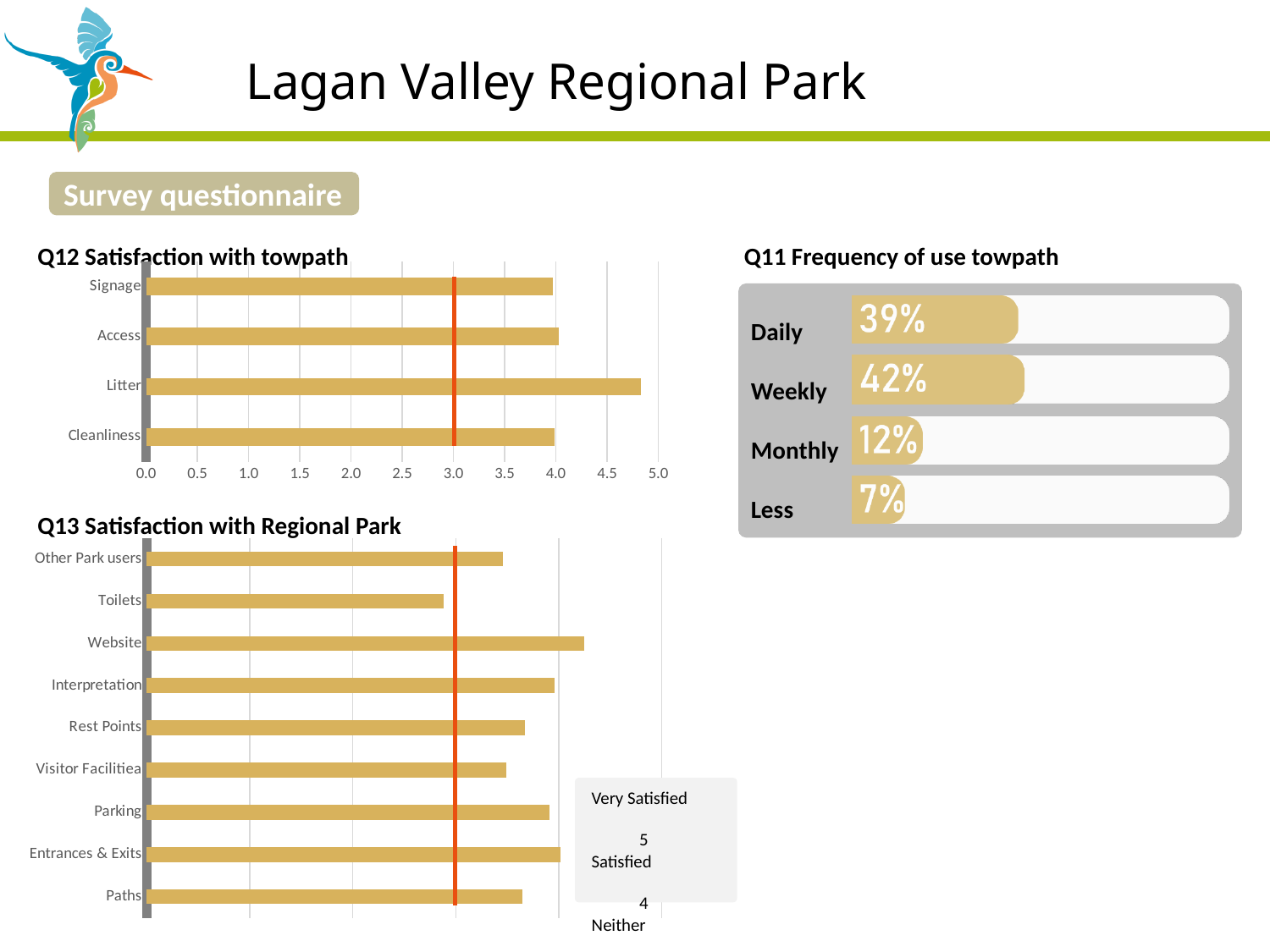
How many categories are shown in the 'Q12 Satisfaction with towpath' chart? 4 In the 'Q12 Satisfaction with towpath' chart, is the value for Cleanliness greater or less than 3.0? greater In the 'Q11 Frequency of use towpath' chart, what is the value for Weekly? 42% How many categories are shown in the 'Q13 Satisfaction with Regional Park' chart? 9 In the 'Q13 Satisfaction with Regional Park' chart, which is larger, the value for Interpretation or the value for Rest Points? Interpretation In the 'Q13 Satisfaction with Regional Park' chart, which category has the highest value? Website In the 'Q12 Satisfaction with towpath' chart, is the value for Litter greater or less than 4.5? greater In the 'Q13 Satisfaction with Regional Park' chart, which category has the lowest value? Toilets In the 'Q11 Frequency of use towpath' chart, which category has the lowest value? Less In the 'Q12 Satisfaction with towpath' chart, which category has the highest value? Litter In the 'Q11 Frequency of use towpath' chart, what is the difference between the Daily and Monthly values? 27% What kind of chart is the 'Q12 Satisfaction with towpath' chart? bar chart